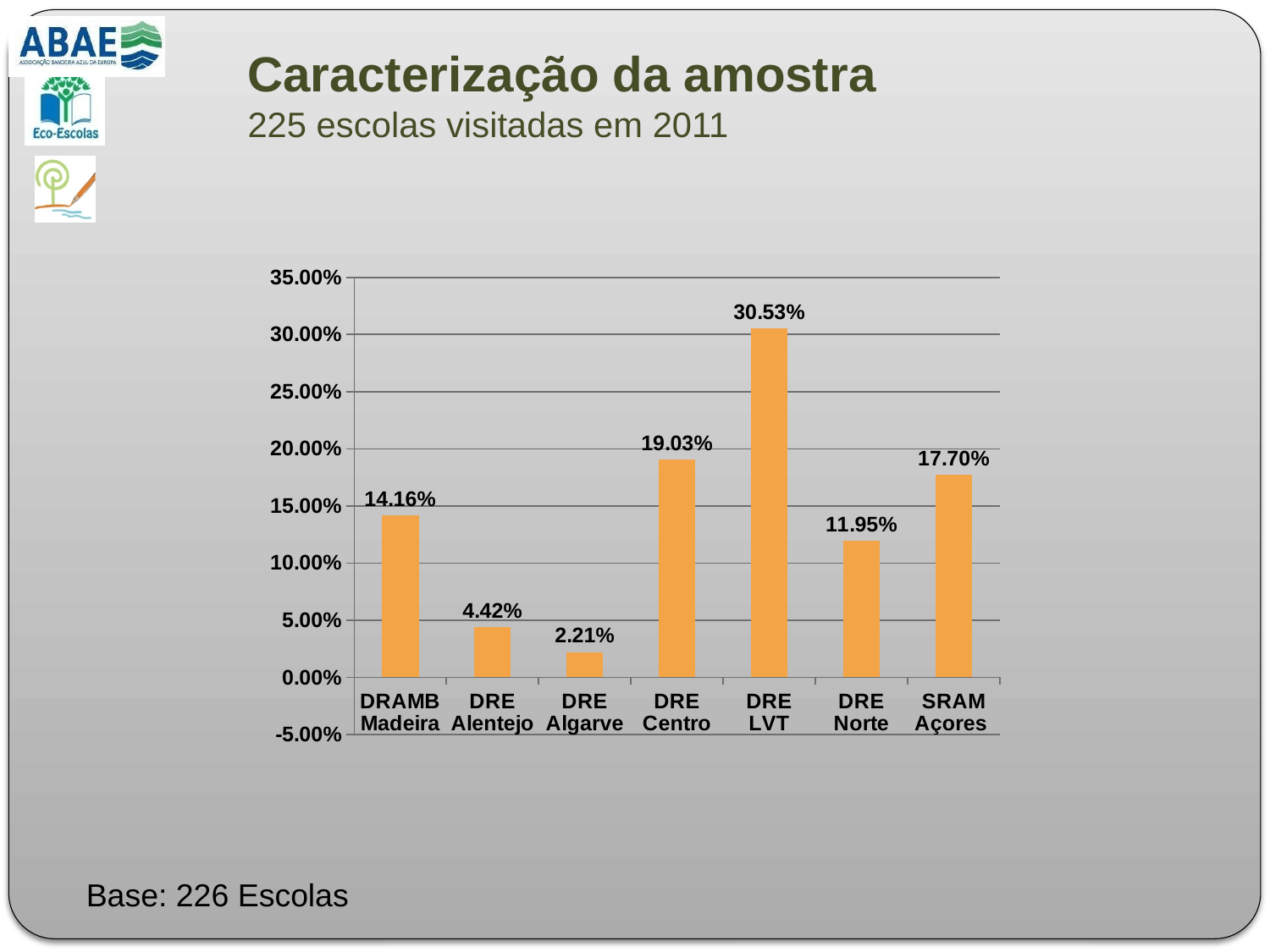
What is the value for DRE LVT? 30.53% What kind of chart is shown on the slide? Bar chart How many categories are shown on the x axis? 7 What is the difference between the values for DRE LVT and DRE Centro? 11.50% What is the value for DRE Norte? 11.95% What is the value for DRE Algarve? 2.21% What is the title of the slide containing the chart? Caracterização da amostra Which category has the highest value? DRE LVT Which is larger, the value for DRE Centro or the value for SRAM Açores? DRE Centro What is the difference between the values for DRAMB Madeira and DRE Norte? 2.21% Which category has the lowest value? DRE Algarve What is the value for SRAM Açores? 17.70%